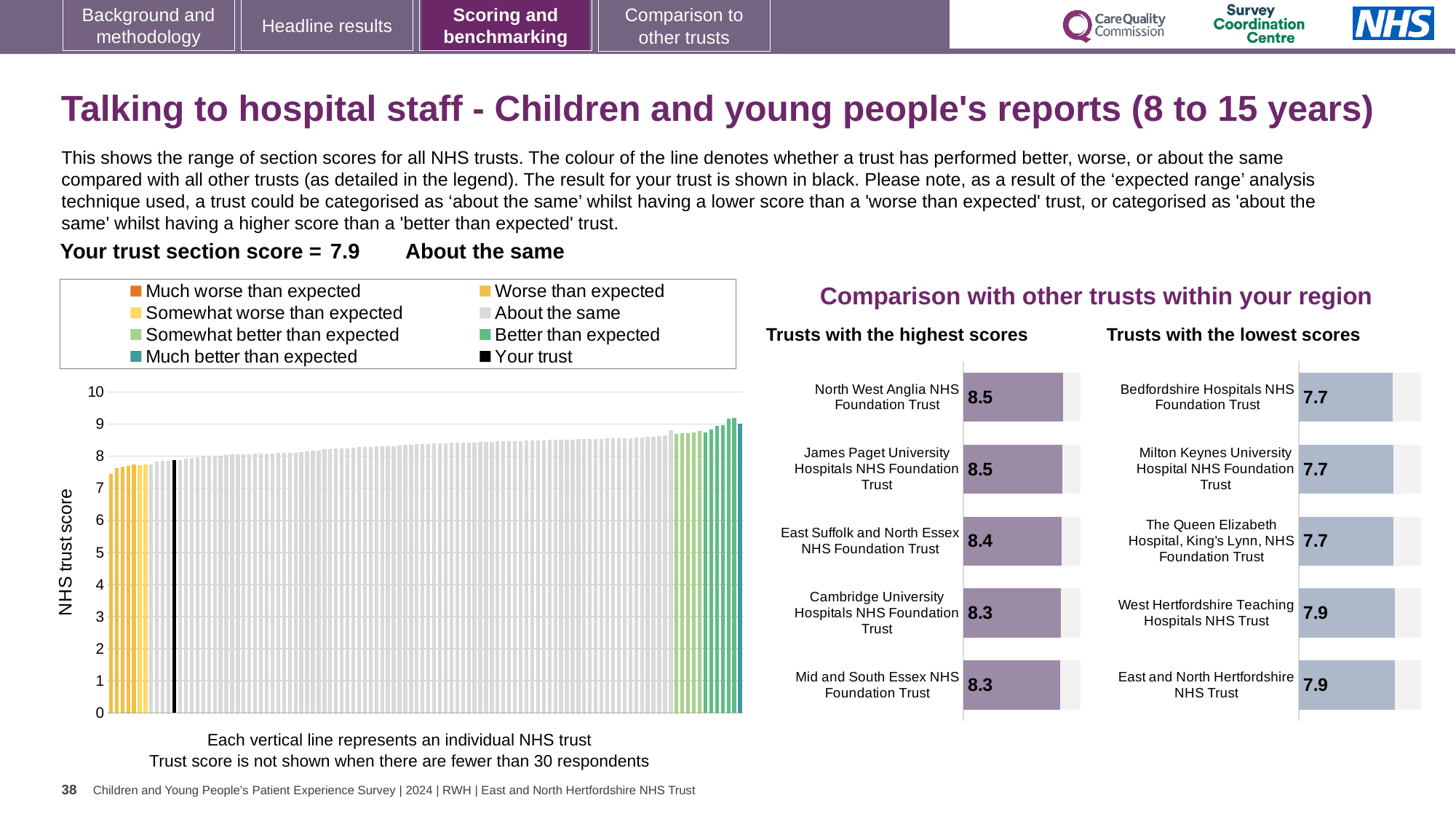
In the 'Trusts with the highest scores' chart, what is the difference between the score for North West Anglia NHS Foundation Trust and the score for Cambridge University Hospitals NHS Foundation Trust? 0.2 What kind of chart is the large chart on the left with the y axis labelled 'NHS trust score'? bar chart In the 'Trusts with the lowest scores' chart, which trust has the lowest score among those listed, Bedfordshire Hospitals NHS Foundation Trust or West Hertfordshire Teaching Hospitals NHS Trust? Bedfordshire Hospitals NHS Foundation Trust In the 'Trusts with the highest scores' chart, what is the score for North West Anglia NHS Foundation Trust? 8.5 How many entries does the legend of the large chart on the left list? 8 In the large chart on the left, is the value of the tallest bar greater or less than 9? greater In the 'Trusts with the highest scores' chart, what is the score for East Suffolk and North Essex NHS Foundation Trust? 8.4 In the large chart on the left, do the trust scores rise or fall from left to right? rise In the 'Trusts with the lowest scores' chart, what is the score for West Hertfordshire Teaching Hospitals NHS Trust? 7.9 In the 'Trusts with the highest scores' chart, how many trusts are listed? 5 Which is larger: the score for Mid and South Essex NHS Foundation Trust in the 'Trusts with the highest scores' chart or the score for East and North Hertfordshire NHS Trust in the 'Trusts with the lowest scores' chart? Mid and South Essex NHS Foundation Trust In the 'Trusts with the lowest scores' chart, what is the score for Bedfordshire Hospitals NHS Foundation Trust? 7.7